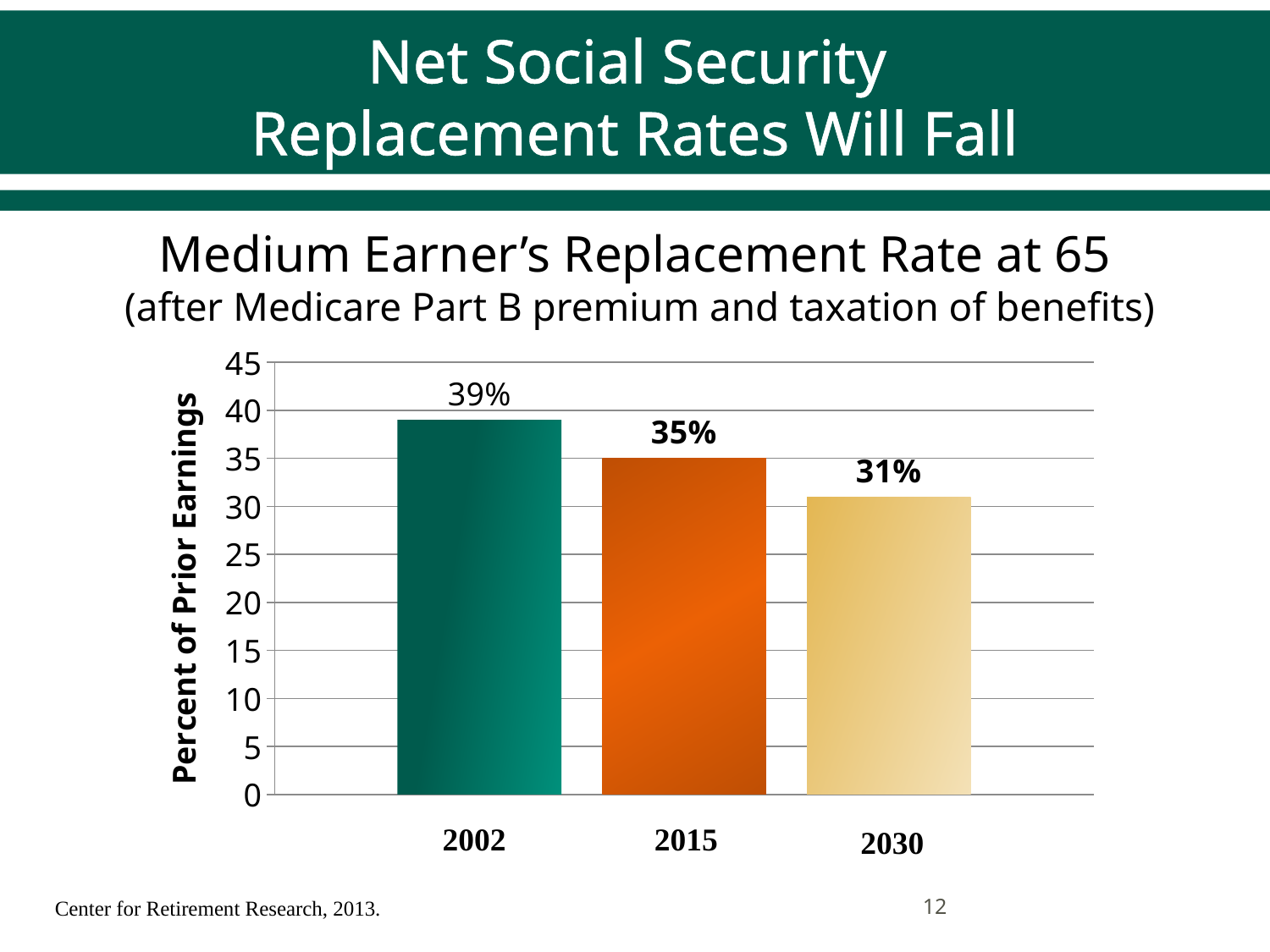
Is the value for 2030 greater or less than 35? less Which is larger, the replacement rate for 2002 or for 2015? 2002 Which year has the highest replacement rate? 2002 What is the replacement rate shown for 2030? 31% What is the replacement rate shown for 2002? 39% What is the difference between the replacement rates for 2002 and 2030? 8 percentage points What is the difference between the replacement rates for 2015 and 2030? 4 percentage points How many years are shown on the chart? 3 Which year has the lowest replacement rate? 2030 What is the replacement rate shown for 2015? 35% What kind of chart is shown on the slide? Bar chart Do the replacement rates rise or fall from 2002 to 2030? Fall